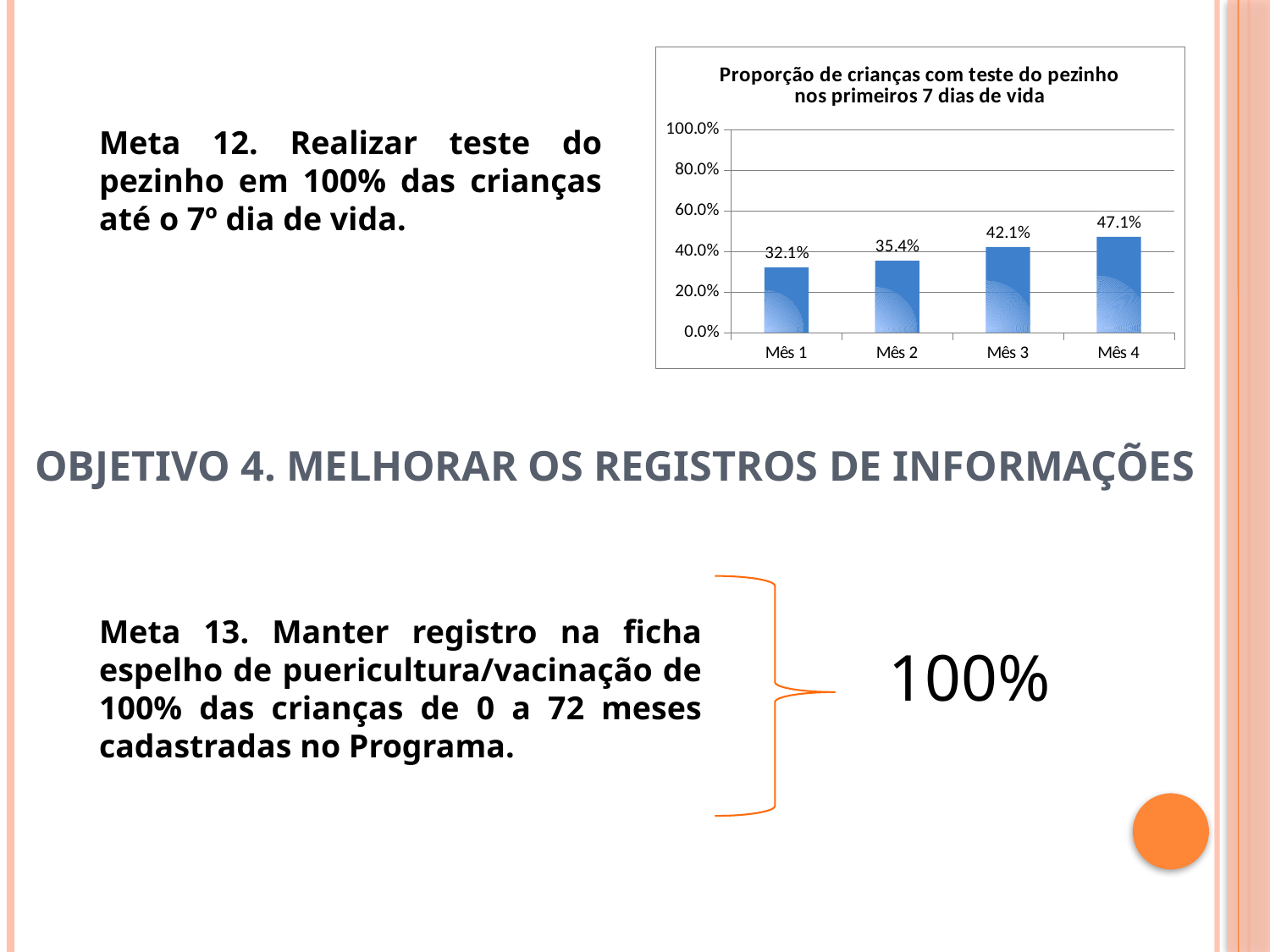
What is the difference between the values for Mês 3 and Mês 2? 6.7% What is the value for Mês 4? 47.1% Which is larger, the value for Mês 2 or the value for Mês 3? Mês 3 What kind of chart is shown? bar chart Which month has the highest proportion? Mês 4 Is the value for Mês 4 greater or less than 60.0%? less What is the difference between the values for Mês 4 and Mês 1? 15.0% What is the value for Mês 1? 32.1% Which month has the lowest proportion? Mês 1 What is the value for Mês 3? 42.1% How many months are shown on the x axis? 4 Do the values rise or fall from Mês 1 to Mês 4? rise